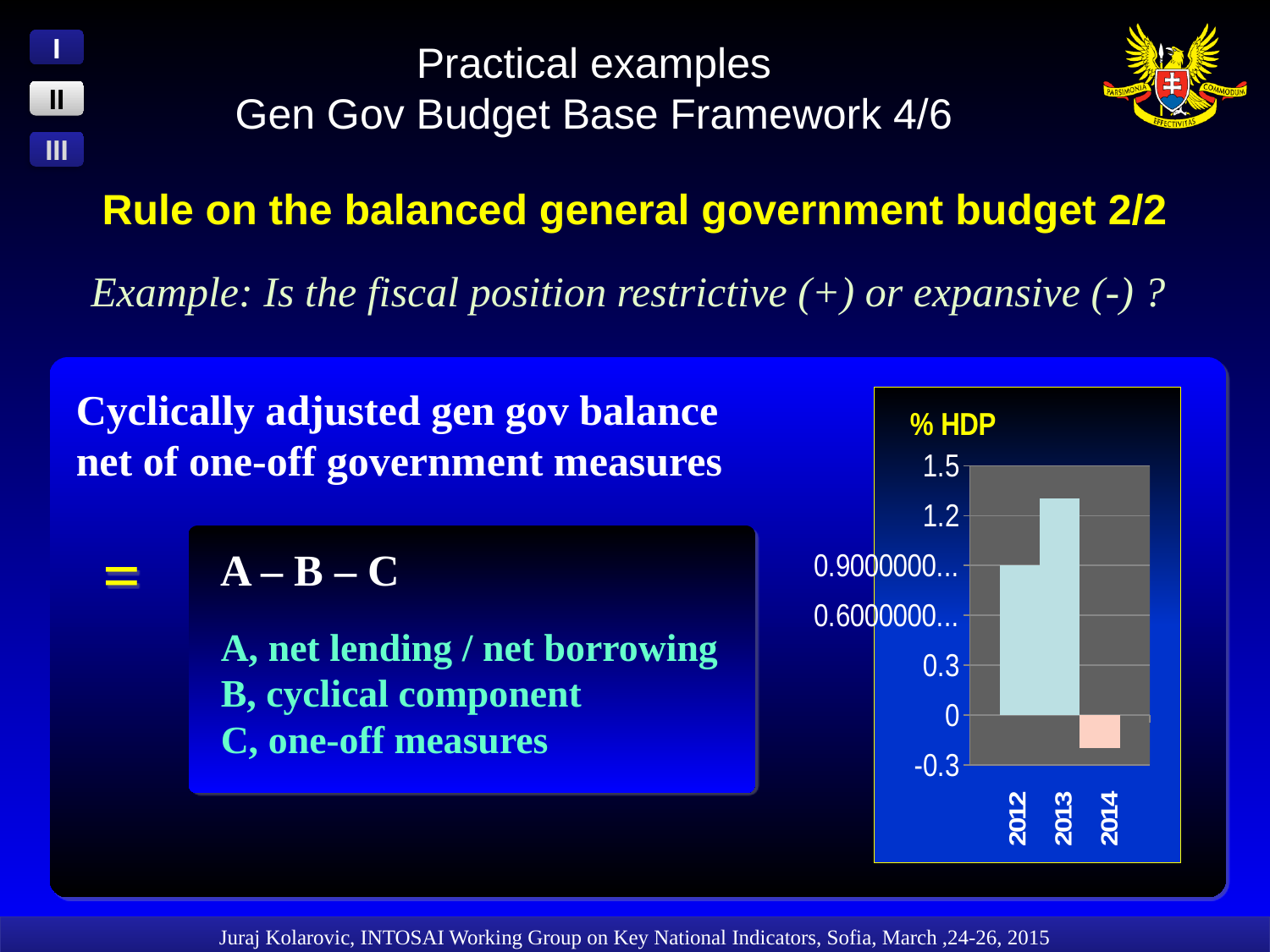
Which year has the highest value in the chart? 2013 Is the value for 2014 greater or less than 0? less Which year has the larger value, 2012 or 2014? 2012 Which year has the lowest value in the chart? 2014 Is the value for 2013 greater or less than 0.9? greater Is the value for 2014 greater or less than -0.3? greater What is the title shown above the chart? % HDP Does the value rise or fall from 2013 to 2014? fall What kind of chart is shown on the slide? bar chart How many years are shown on the x axis of the chart? 3 Which year has the larger value, 2012 or 2013? 2013